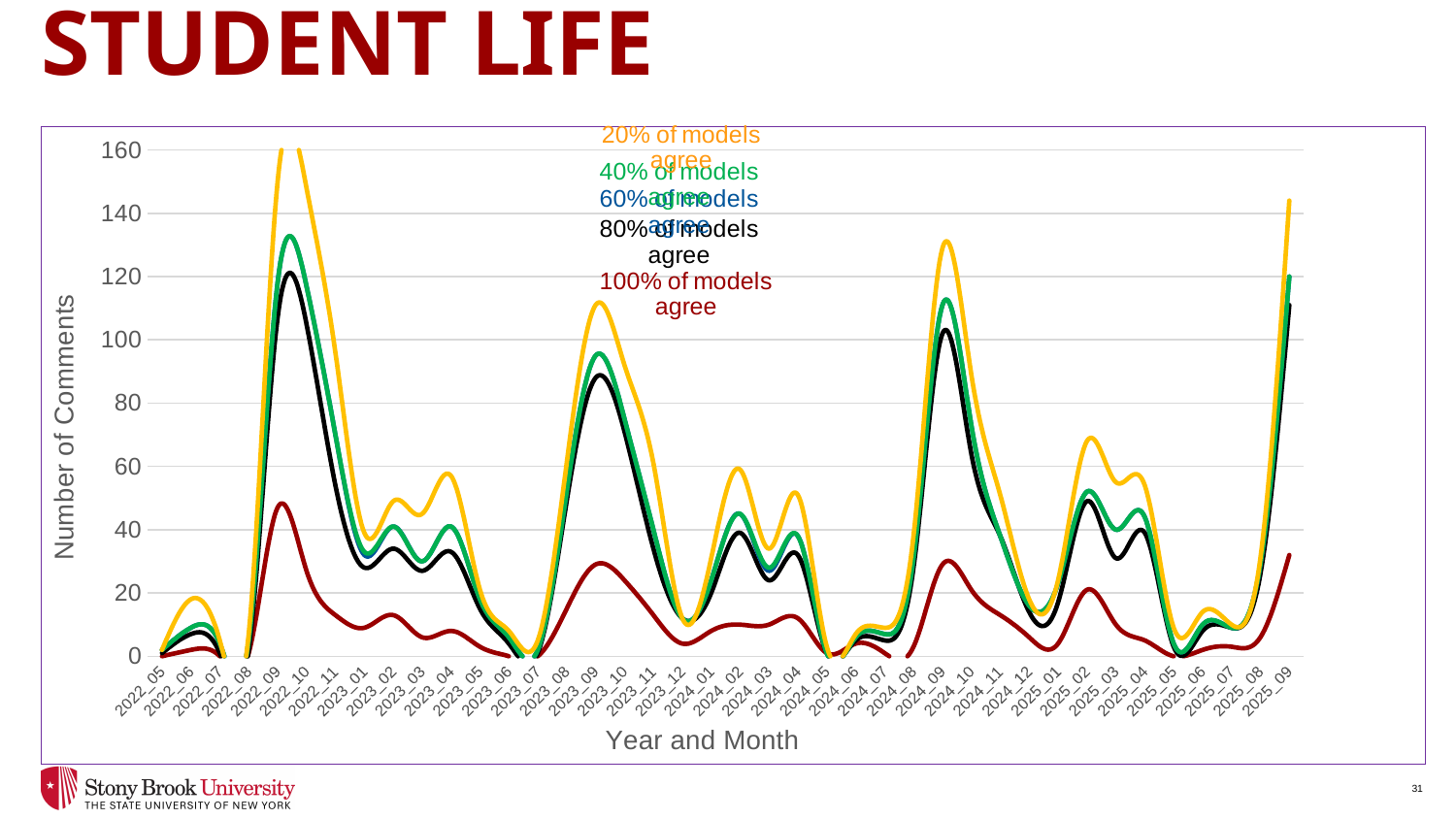
Is the value of the '20% of models agree' series at 2024_09 greater or less than 120? greater How many year-month categories are shown along the x axis? 40 Is the value of the '20% of models agree' series at 2022_09 greater or less than 140? greater What is the title of the y axis? Number of Comments What is the title of the x axis? Year and Month Is the value of the '100% of models agree' series at 2023_09 greater or less than 20? greater Which series has the lowest values across the chart? 100% of models agree For the '100% of models agree' series, is the value at 2022_09 or at 2023_09 larger? 2022_09 What kind of chart is shown on the slide? line chart How many series does the legend list? 5 Which series has the highest values across the chart? 20% of models agree